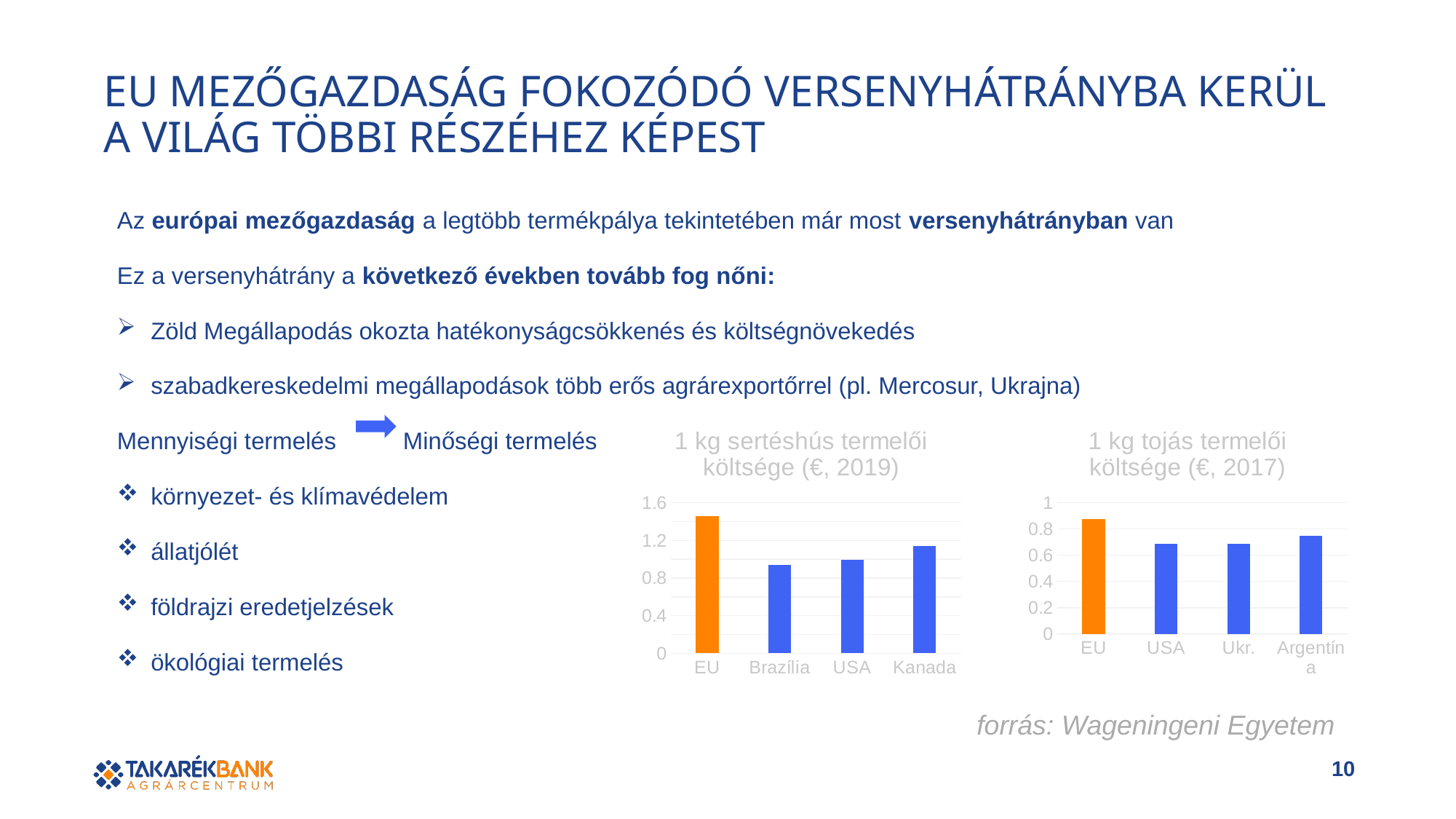
In the "1 kg tojás termelői költsége (€, 2017)" chart, which category has the highest value? EU In the "1 kg sertéshús termelői költsége (€, 2019)" chart, which category has the highest value? EU In the "1 kg sertéshús termelői költsége (€, 2019)" chart, which is larger, the value for Kanada or the value for Brazília? Kanada How many categories are shown in the "1 kg tojás termelői költsége (€, 2017)" chart? 4 How many categories are shown in the "1 kg sertéshús termelői költsége (€, 2019)" chart? 4 In the "1 kg sertéshús termelői költsége (€, 2019)" chart, is the value for EU greater or less than 1.2? greater In the "1 kg tojás termelői költsége (€, 2017)" chart, what colour is the EU bar? orange What kind of chart is the "1 kg sertéshús termelői költsége (€, 2019)" chart? bar chart In the "1 kg tojás termelői költsége (€, 2017)" chart, is the value for EU greater or less than 0.8? greater In the "1 kg tojás termelői költsége (€, 2017)" chart, is the value for USA greater or less than 0.8? less In the "1 kg tojás termelői költsége (€, 2017)" chart, which is larger, the value for EU or the value for Argentína? EU